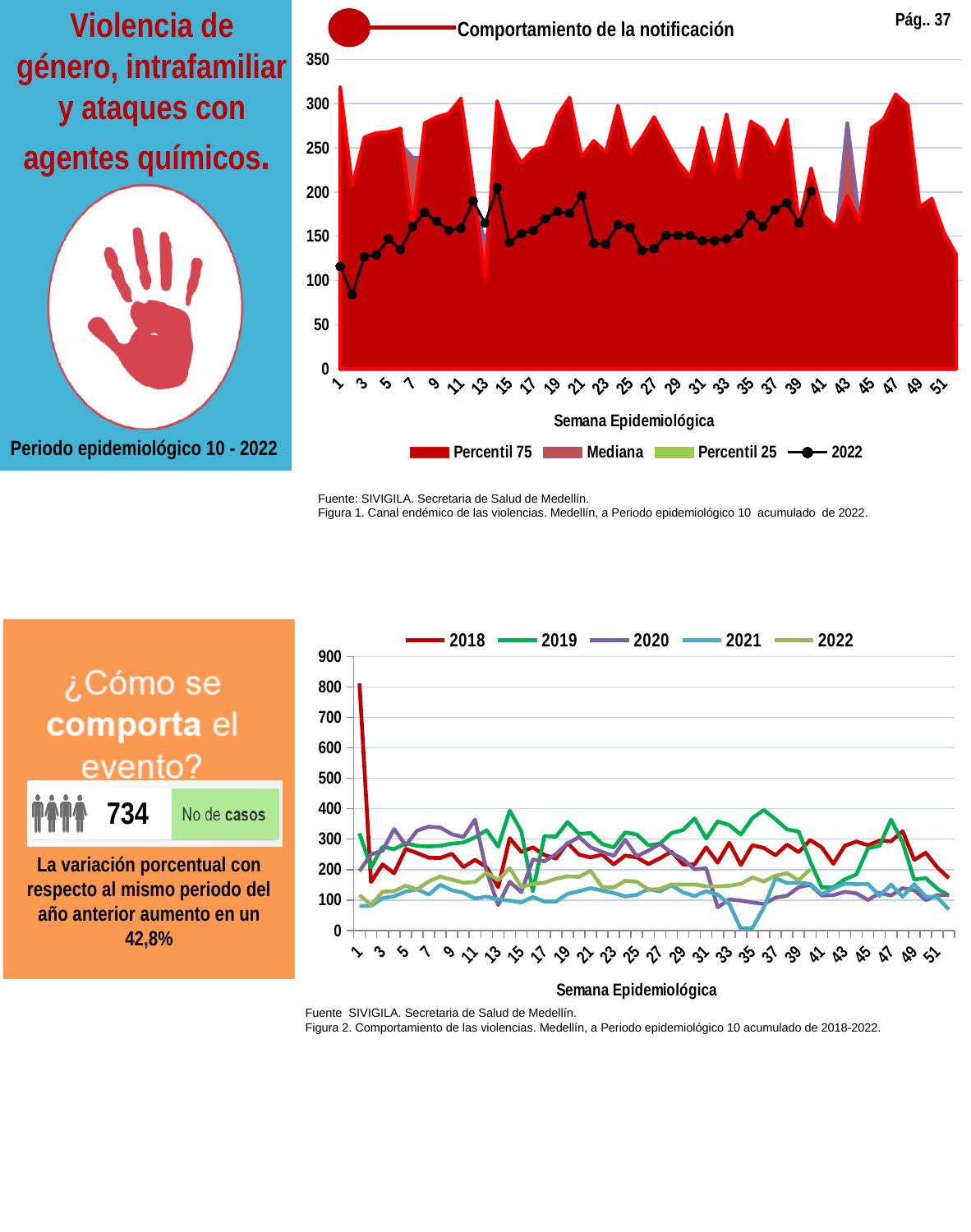
In the bottom chart (Figura 2), how many series does the legend list? 5 What kind of chart is the bottom chart (Figura 2)? Line chart What is the x-axis title of the top chart 'Comportamiento de la notificación'? Semana Epidemiológica In the bottom chart (Figura 2), is the 2021 value at week 35 greater or less than 100? less In the bottom chart (Figura 2), which series has the lowest value at week 35? 2021 In the top chart 'Comportamiento de la notificación', is the 2022 value at week 26 greater or less than 150? less In the top chart 'Comportamiento de la notificación', is the 2022 value at week 2 greater or less than 100? less In the top chart titled 'Comportamiento de la notificación', how many series does the legend list? 4 In the bottom chart (Figura 2), does the 2018 line rise or fall from week 47 to week 52? fall In the bottom chart (Figura 2), which series has the highest value at week 1? 2018